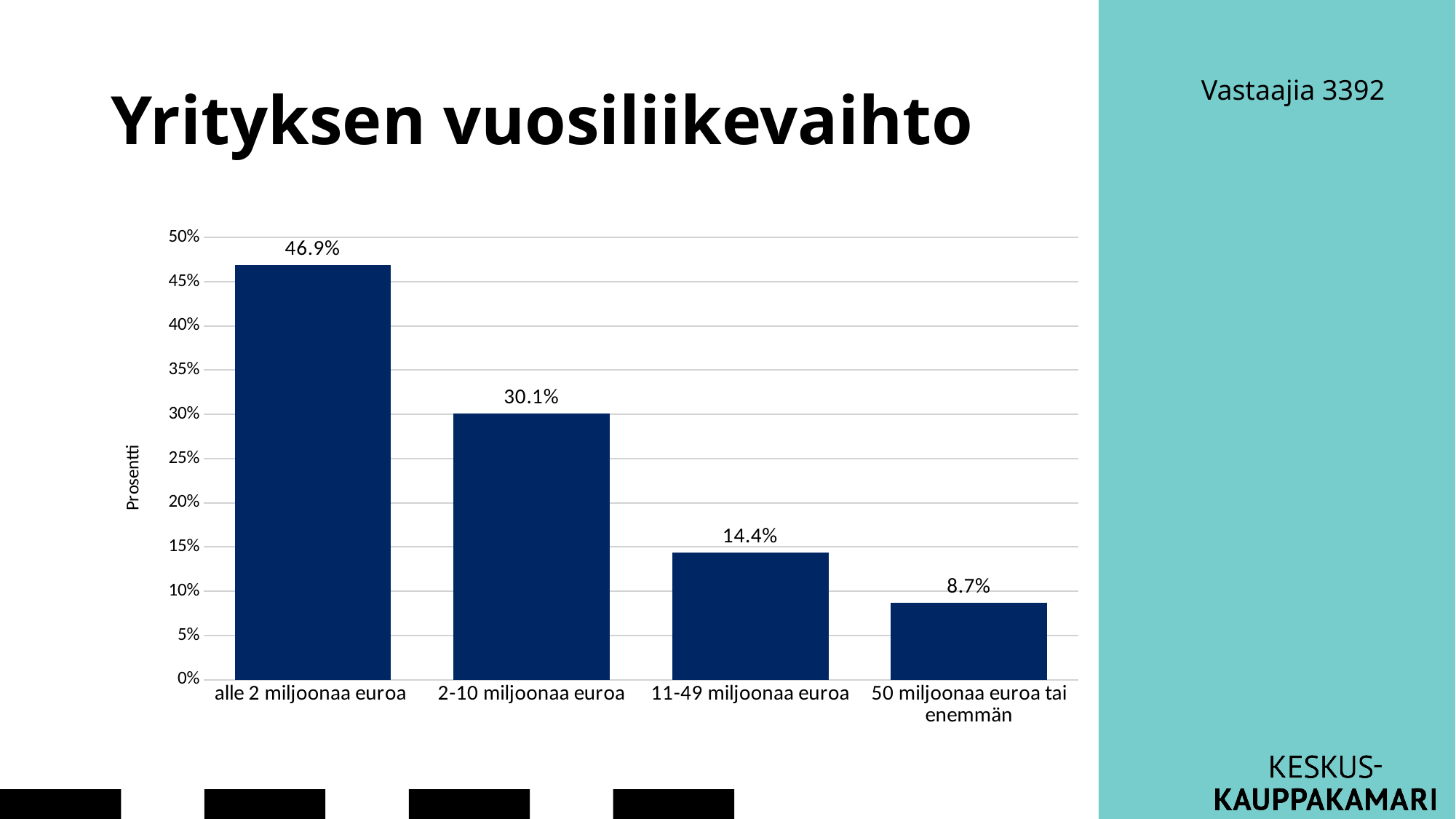
What is the value for "2-10 miljoonaa euroa"? 30.1% Which is larger, the value for "11-49 miljoonaa euroa" or "50 miljoonaa euroa tai enemmän"? 11-49 miljoonaa euroa What is the value for "alle 2 miljoonaa euroa"? 46.9% How many categories are shown in the chart? 4 Which category has the lowest value? 50 miljoonaa euroa tai enemmän What is the value for "50 miljoonaa euroa tai enemmän"? 8.7% Is the value for "2-10 miljoonaa euroa" greater or less than 25%? greater Which category has the highest value? alle 2 miljoonaa euroa What is the difference between the values for "alle 2 miljoonaa euroa" and "2-10 miljoonaa euroa"? 16.8% Do the values rise or fall from left to right along the x axis? fall What kind of chart is shown on the slide? bar chart What is the value for "11-49 miljoonaa euroa"? 14.4%